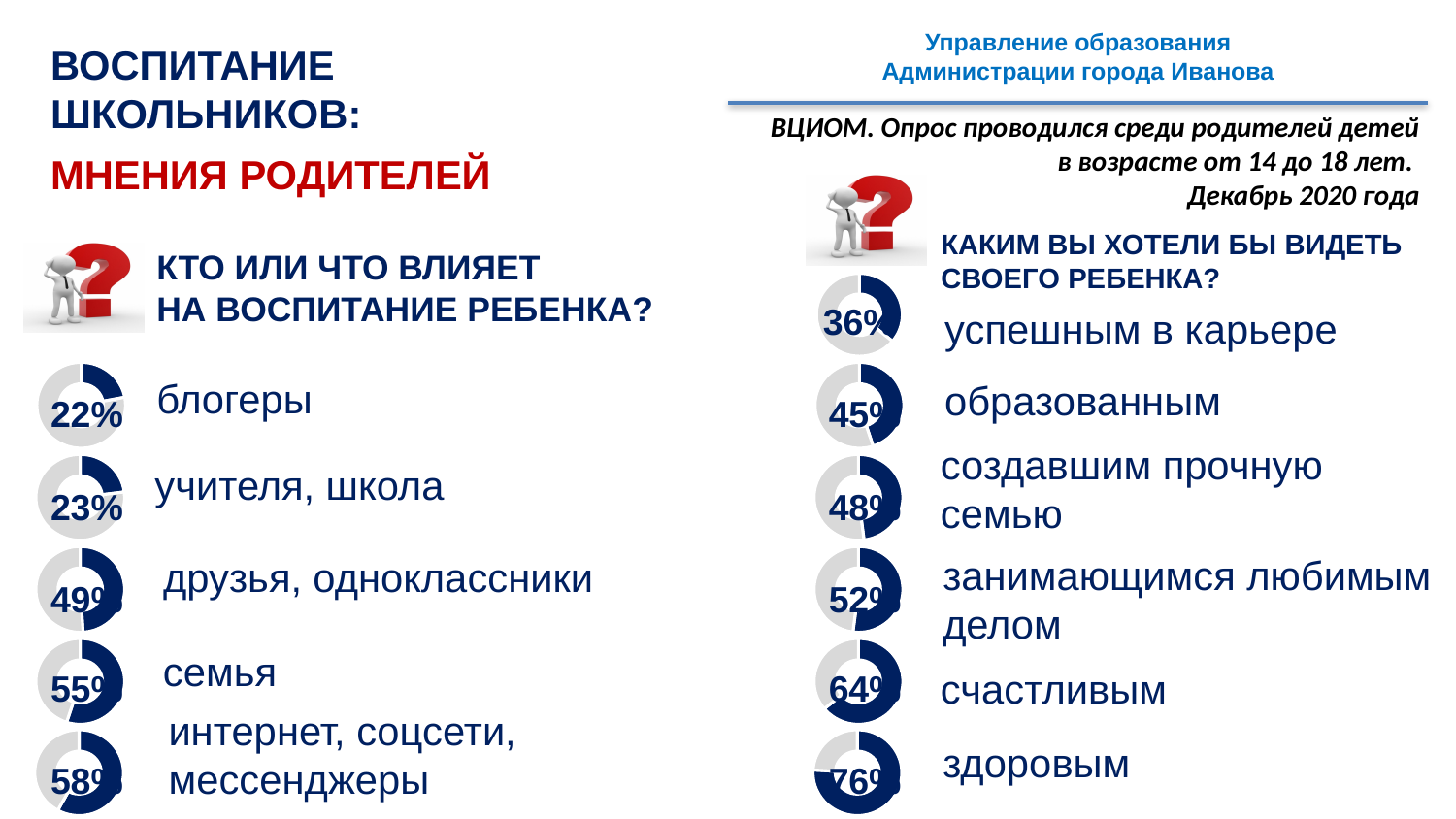
In the chart 'Кто или что влияет на воспитание ребенка?', which category has the highest value? интернет, соцсети, мессенджеры In the chart 'Кто или что влияет на воспитание ребенка?', what is the value for семья? 55% In the chart 'Каким вы хотели бы видеть своего ребенка?', what is the value for образованным? 45% In the chart 'Каким вы хотели бы видеть своего ребенка?', which is larger: создавшим прочную семью or занимающимся любимым делом? занимающимся любимым делом In the chart 'Каким вы хотели бы видеть своего ребенка?', which category has the highest value? здоровым In the chart 'Кто или что влияет на воспитание ребенка?', what is the difference between семья and друзья, одноклассники? 6% In the chart 'Каким вы хотели бы видеть своего ребенка?', which category has the lowest value? успешным в карьере In the chart 'Каким вы хотели бы видеть своего ребенка?', what is the value for счастливым? 64% In the chart 'Кто или что влияет на воспитание ребенка?', what is the value for блогеры? 22% In the chart 'Кто или что влияет на воспитание ребенка?', how many categories are shown? 5 In the chart 'Каким вы хотели бы видеть своего ребенка?', how many categories are shown? 6 In the chart 'Кто или что влияет на воспитание ребенка?', which category has the lowest value? блогеры